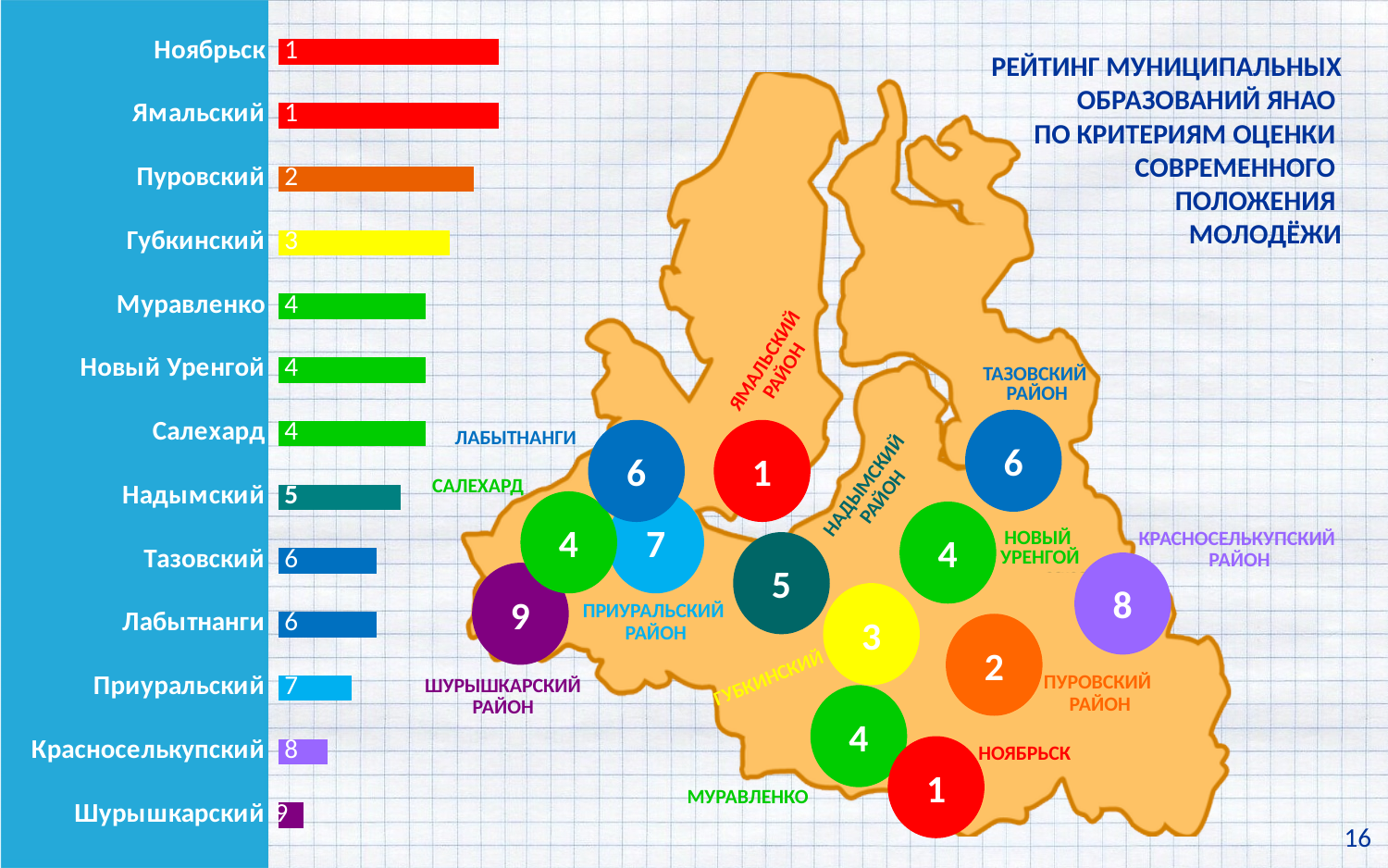
What colour are the bars for Ноябрьск and Ямальский in the bar chart? red What is the difference between the values for Шурышкарский and Пуровский in the bar chart? 7 Which category is listed first (at the top) of the bar chart? Ноябрьск What is the value shown for Красноселькупский in the bar chart? 8 How many categories are shown in the bar chart? 13 What kind of chart is shown on the left of the slide? bar chart What is the value shown for Надымский in the bar chart? 5 What is the value shown for Губкинский in the bar chart? 3 What is the value shown for Пуровский in the bar chart? 2 What is the value shown for Приуральский in the bar chart? 7